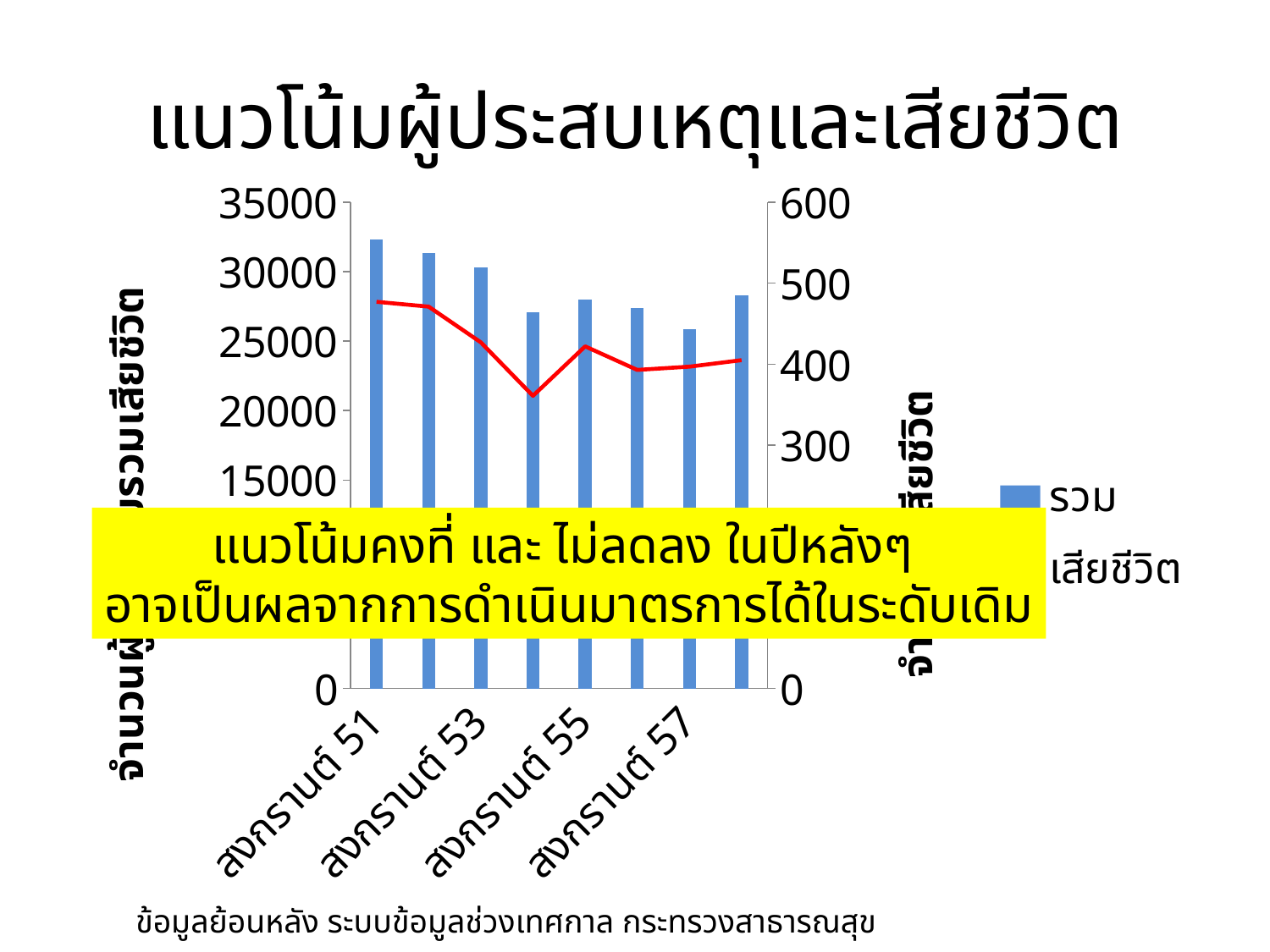
Which category has the tallest bar for รวม? สงกรานต์ 51 Do the รวม bars generally rise or fall from สงกรานต์ 51 to สงกรานต์ 57? fall Is the เสียชีวิต value for สงกรานต์ 51 greater or less than 400 on the right axis? greater What is the title of the chart? แนวโน้มผู้ประสบเหตุและเสียชีวิต Is the รวม value for สงกรานต์ 51 greater or less than 30000? greater How many series does the legend list? 2 Which labelled category has the shortest bar for รวม? สงกรานต์ 57 Which has the larger รวม bar, สงกรานต์ 53 or สงกรานต์ 55? สงกรานต์ 53 Is the เสียชีวิต line higher at สงกรานต์ 51 or at สงกรานต์ 57? สงกรานต์ 51 What kind of chart is shown on the slide? A combined bar and line chart How many bars are plotted in the chart? 8 Is the รวม value for สงกรานต์ 55 greater or less than 30000? less